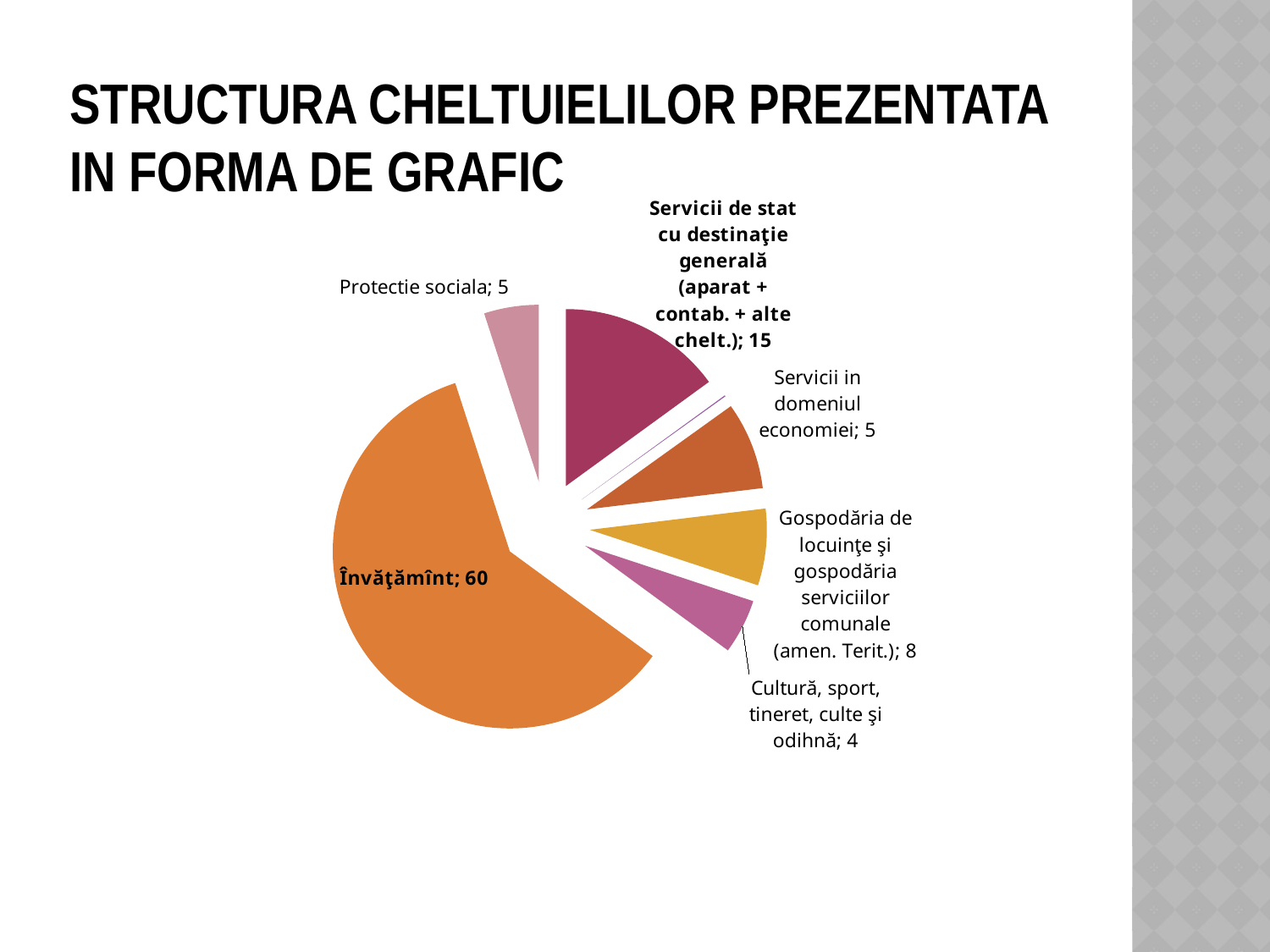
Which labeled category has the largest slice of the pie? Învăţămînt What is the value shown for Învăţămînt? 60 What is the title of the slide containing the chart? STRUCTURA CHELTUIELILOR PREZENTATA IN FORMA DE GRAFIC Which is larger, the value for Servicii de stat cu destinaţie generală or the value for Servicii in domeniul economiei? Servicii de stat cu destinaţie generală What is the value shown for Cultură, sport, tineret, culte şi odihnă? 4 Which is larger, the value for Gospodăria de locuinţe şi gospodăria serviciilor comunale or the value for Protectie sociala? Gospodăria de locuinţe şi gospodăria serviciilor comunale What is the difference between the values for Gospodăria de locuinţe şi gospodăria serviciilor comunale and Cultură, sport, tineret, culte şi odihnă? 4 What type of chart is shown on the slide? pie chart What is the difference between the values for Învăţămînt and Servicii de stat cu destinaţie generală? 45 What is the value shown for Gospodăria de locuinţe şi gospodăria serviciilor comunale (amen. Terit.)? 8 What is the value shown for Servicii de stat cu destinaţie generală (aparat + contab. + alte chelt.)? 15 What is the value shown for Protectie sociala? 5